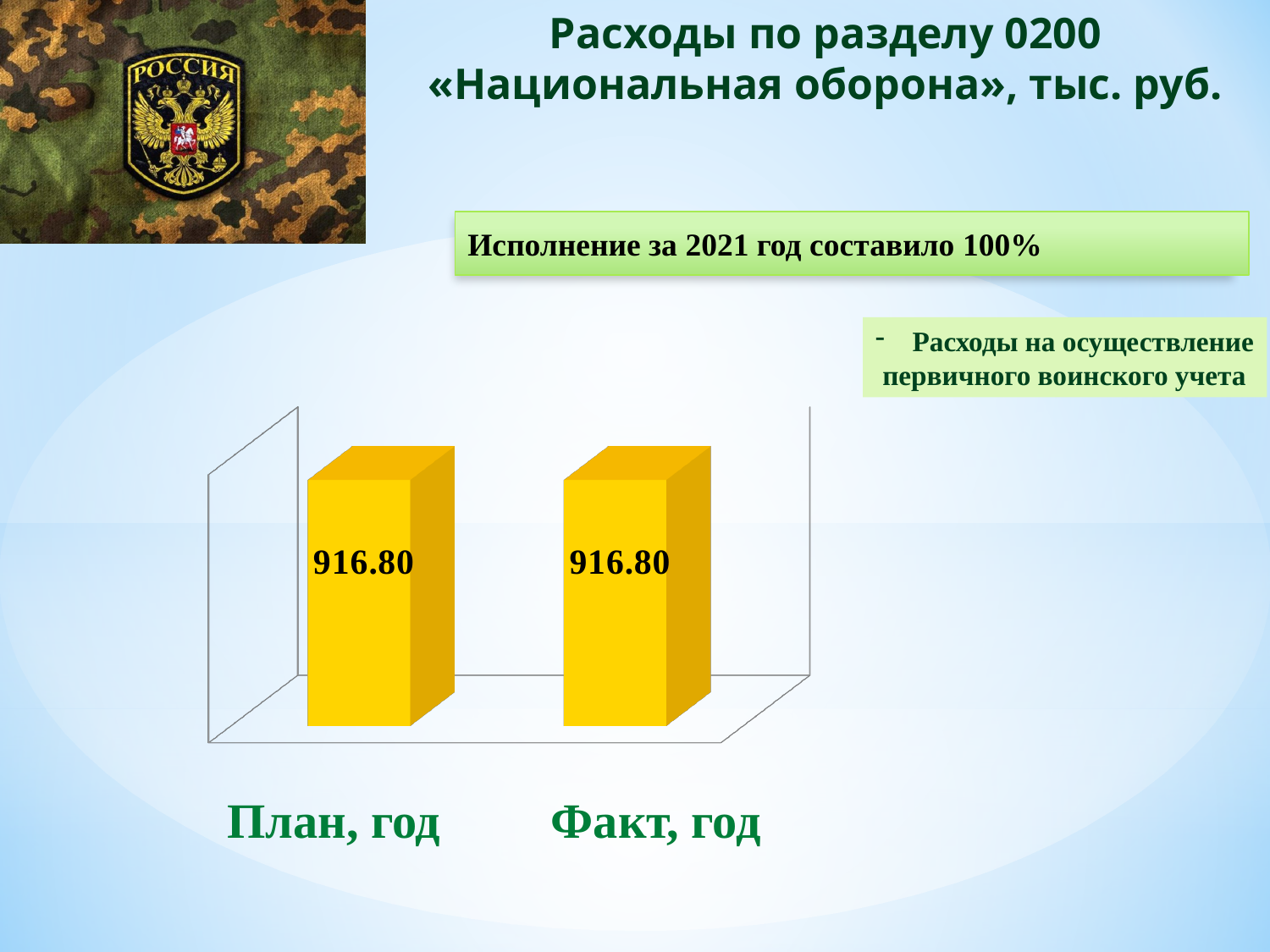
What is the value for План, год? 916.80 What is the value for Факт, год? 916.80 What kind of chart is shown on the slide? Bar chart How many bars are plotted in the chart? 2 What is the difference between the values for План, год and Факт, год? 0.00 Do the values rise, fall or stay the same from План, год to Факт, год? Stay the same What is the title of the chart on the slide? Расходы по разделу 0200 «Национальная оборона», тыс. руб. What are the two category labels on the x axis? План, год and Факт, год Are the values for План, год and Факт, год equal or different? Equal What colour are the bars in the chart? Yellow